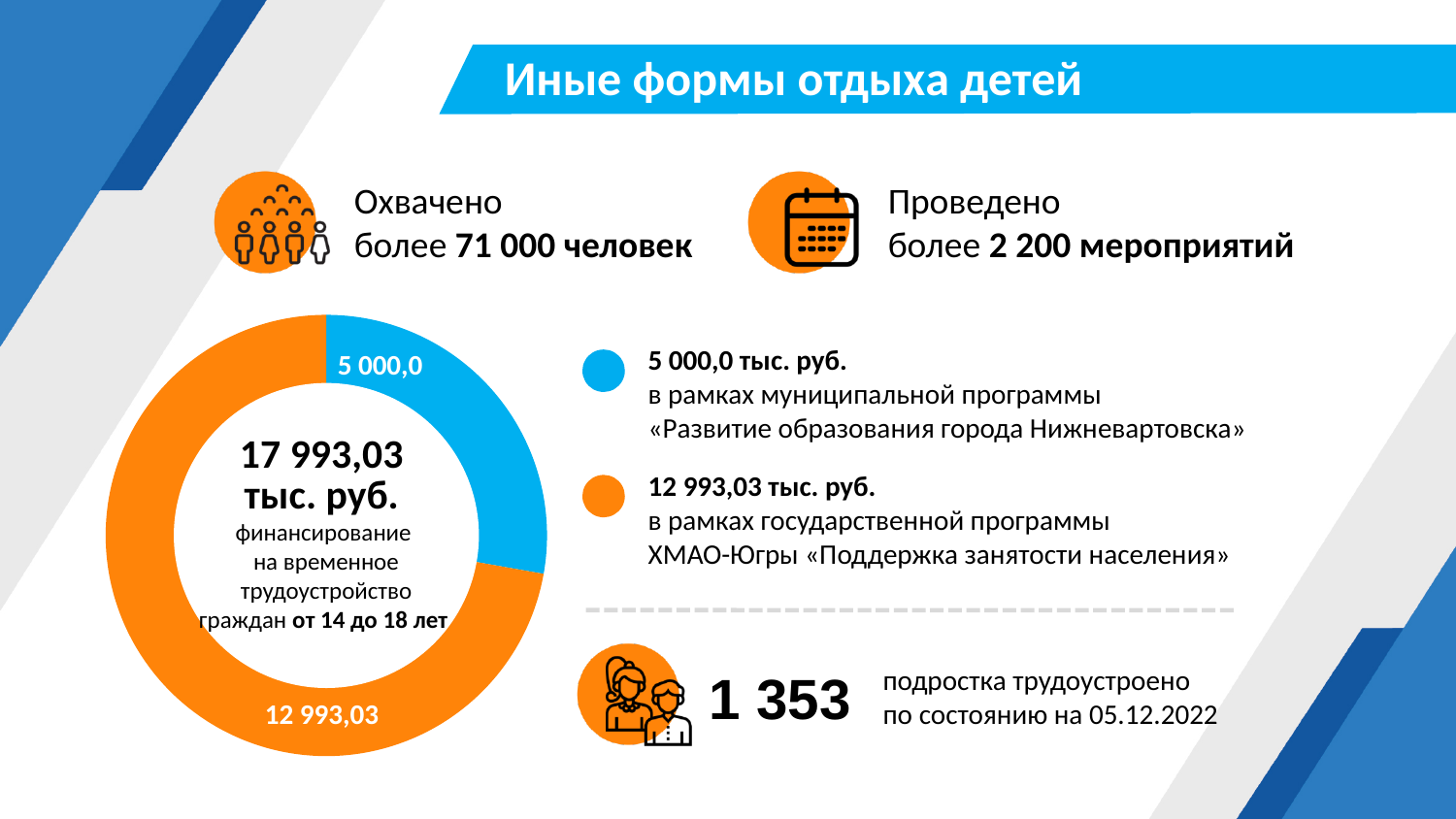
What is the difference between the state programme slice (12 993,03) and the municipal programme slice (5 000,0)? 7 993,03 What colour is the slice for the municipal programme «Развитие образования города Нижневартовска»? blue What total amount of financing is shown in the centre of the pie chart? 17 993,03 тыс. руб. What is the value of the slice for the state programme ХМАО-Югры «Поддержка занятости населения»? 12 993,03 What share of the total financing (17 993,03) does the state programme slice (12 993,03) represent? 72.2% Which programme accounts for the largest slice of the pie chart? государственная программа ХМАО-Югры «Поддержка занятости населения» How many slices does the pie chart have? 2 Which programme accounts for the smallest slice of the pie chart? муниципальная программа «Развитие образования города Нижневартовска» According to the text in the centre of the pie chart, what is the financing for? временное трудоустройство граждан от 14 до 18 лет What is the value of the slice for the municipal programme «Развитие образования города Нижневартовска»? 5 000,0 What kind of chart is shown on the slide? pie chart Which slice is larger: the municipal programme (5 000,0) or the state programme (12 993,03)? the state programme (12 993,03)